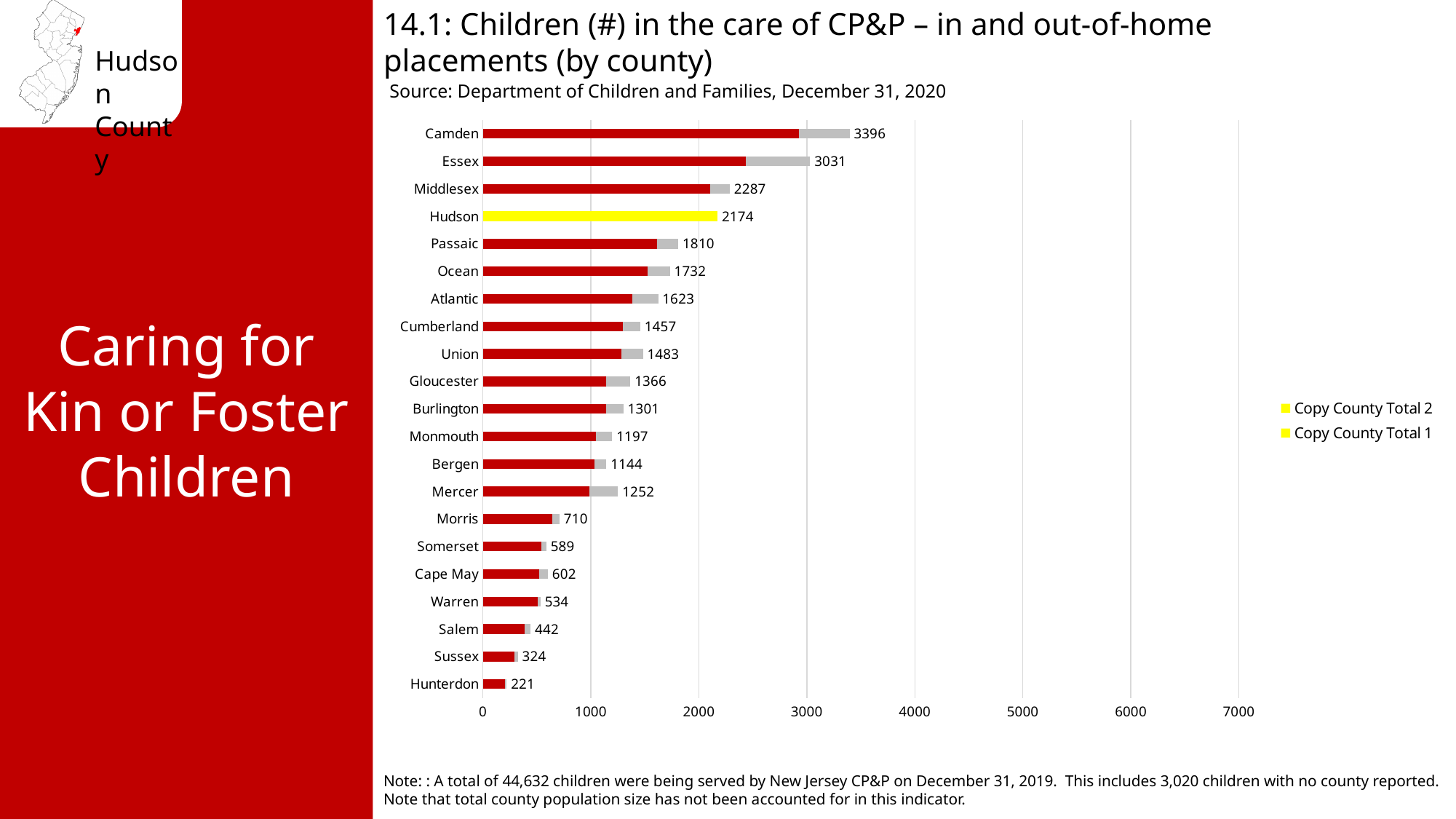
What is the difference between the values for Middlesex and Hudson? 113 Which county has the highest number of children in the care of CP&P? Camden Which county has the lowest number of children in the care of CP&P? Hunterdon How many counties are shown in the chart? 21 Which has a larger value, Mercer or Bergen? Mercer Which has a larger value, Union or Cumberland? Union How many series does the legend list? 2 What is the total number of children in the care of CP&P for Camden County? 3396 What is the value shown for Hudson County? 2174 What is the difference between the values for Camden and Essex? 365 What kind of chart is shown on the slide? Bar chart What is the value shown for Hunterdon County? 221